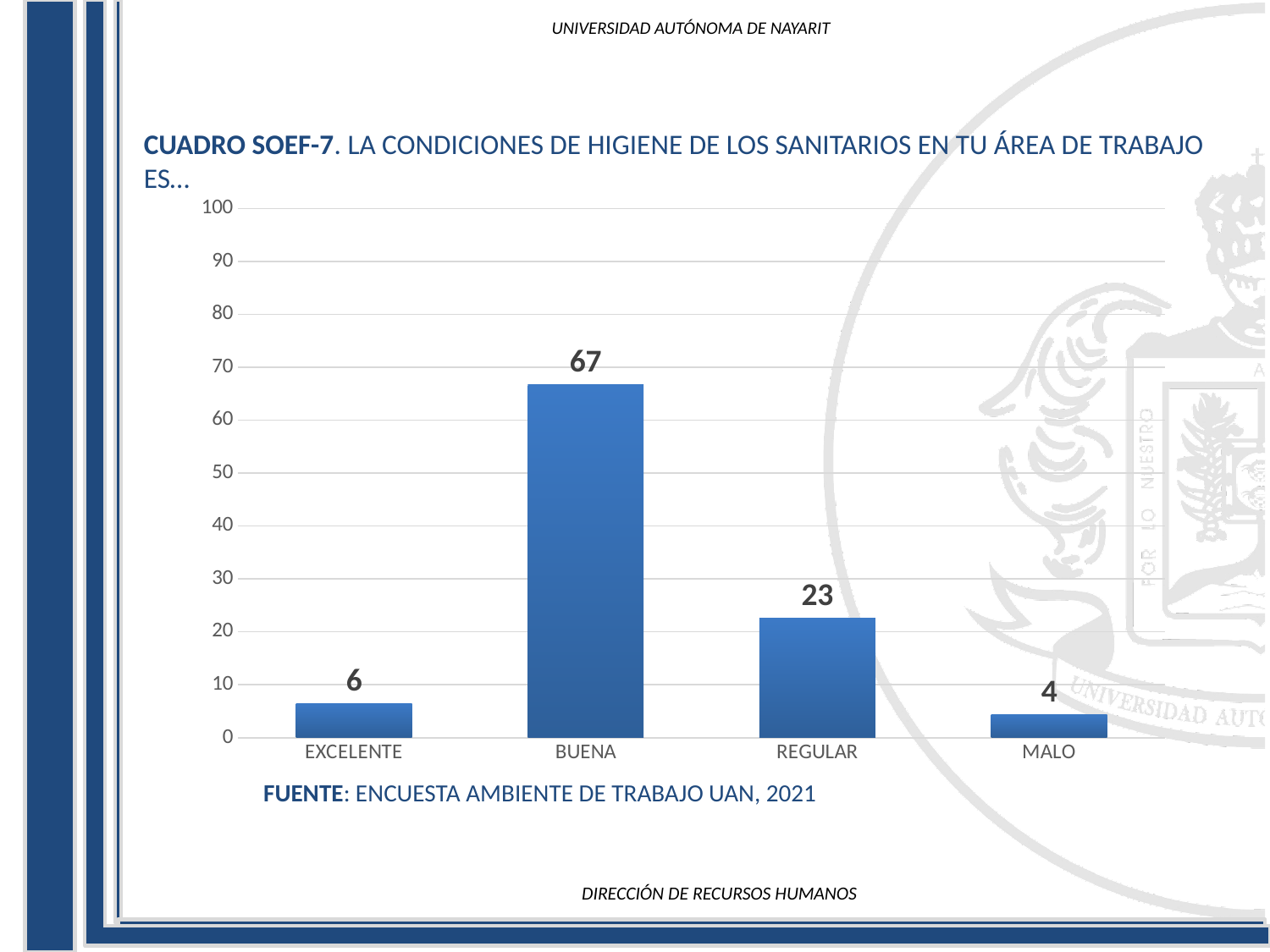
How many categories are shown on the x axis? 4 What is the difference between the values for BUENA and REGULAR? 44 Which category has the highest value? BUENA What is the value for MALO? 4 What is the value for REGULAR? 23 What is the value for BUENA? 67 Which category has the lowest value? MALO What kind of chart is shown on the slide? bar chart What is the value for EXCELENTE? 6 Which is larger, the value for EXCELENTE or the value for MALO? EXCELENTE What source is cited below the chart? ENCUESTA AMBIENTE DE TRABAJO UAN, 2021 Is the value for BUENA greater or less than 60? greater